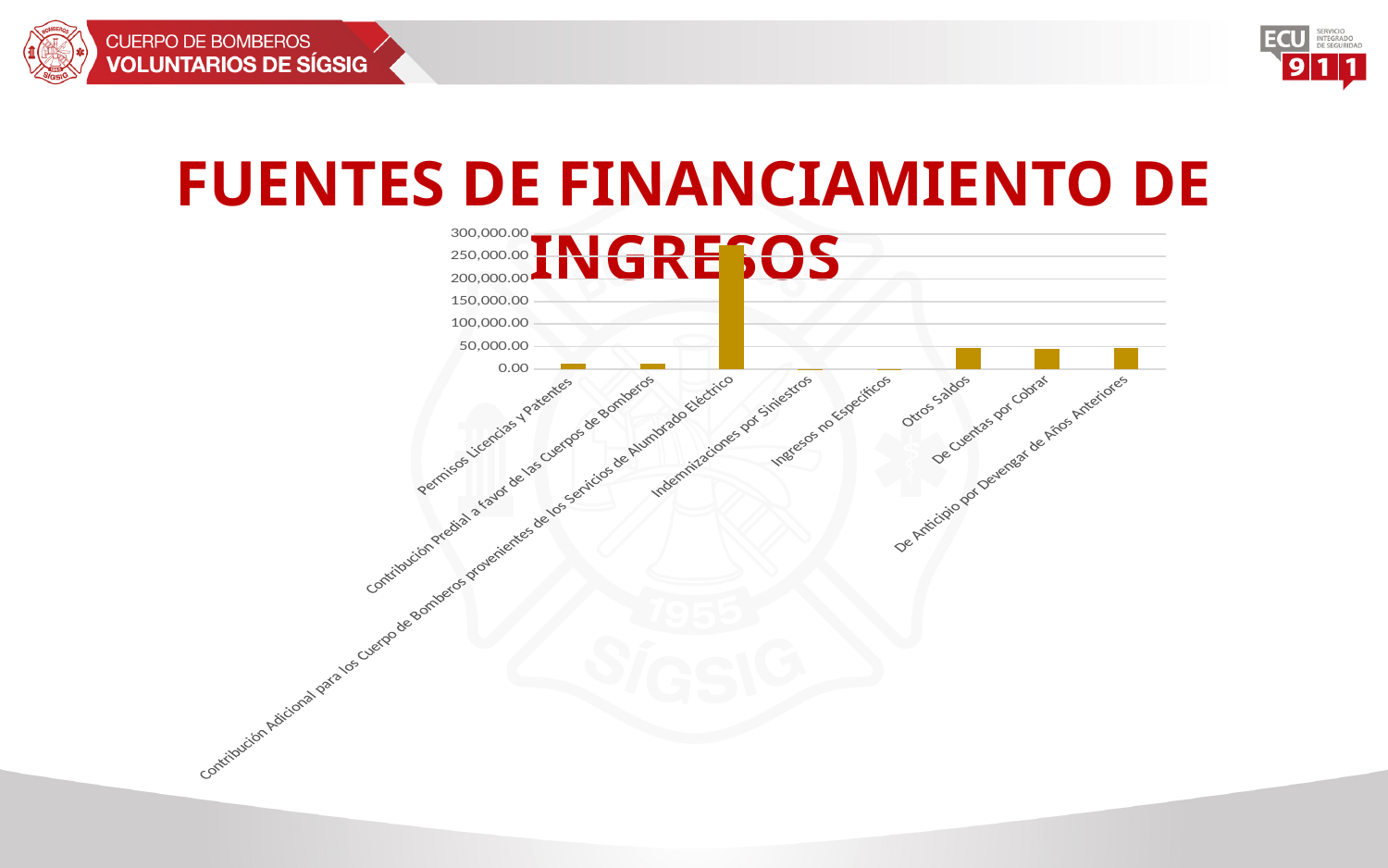
What is the title shown above the chart? FUENTES DE FINANCIAMIENTO DE INGRESOS Is the value for Permisos Licencias y Patentes greater or less than 50,000.00? less What is the highest value shown on the vertical axis of the chart? 300,000.00 Is the value for Otros Saldos greater or less than 100,000.00? less Is the value for De Anticipio por Devengar de Años Anteriores greater or less than 100,000.00? less Which is larger, the value for De Cuentas por Cobrar or the value for Contribución Predial a favor de las Cuerpos de Bomberos? De Cuentas por Cobrar What kind of chart is shown on the slide? bar chart How many categories are plotted on the chart? 8 Which is larger, the value for Otros Saldos or the value for Permisos Licencias y Patentes? Otros Saldos Which is larger, the value for Contribución Adicional para los Cuerpo de Bomberos provenientes de los Servicios de Alumbrado Eléctrico or the value for De Cuentas por Cobrar? Contribución Adicional para los Cuerpo de Bomberos provenientes de los Servicios de Alumbrado Eléctrico Which category has the highest value on the chart? Contribución Adicional para los Cuerpo de Bomberos provenientes de los Servicios de Alumbrado Eléctrico